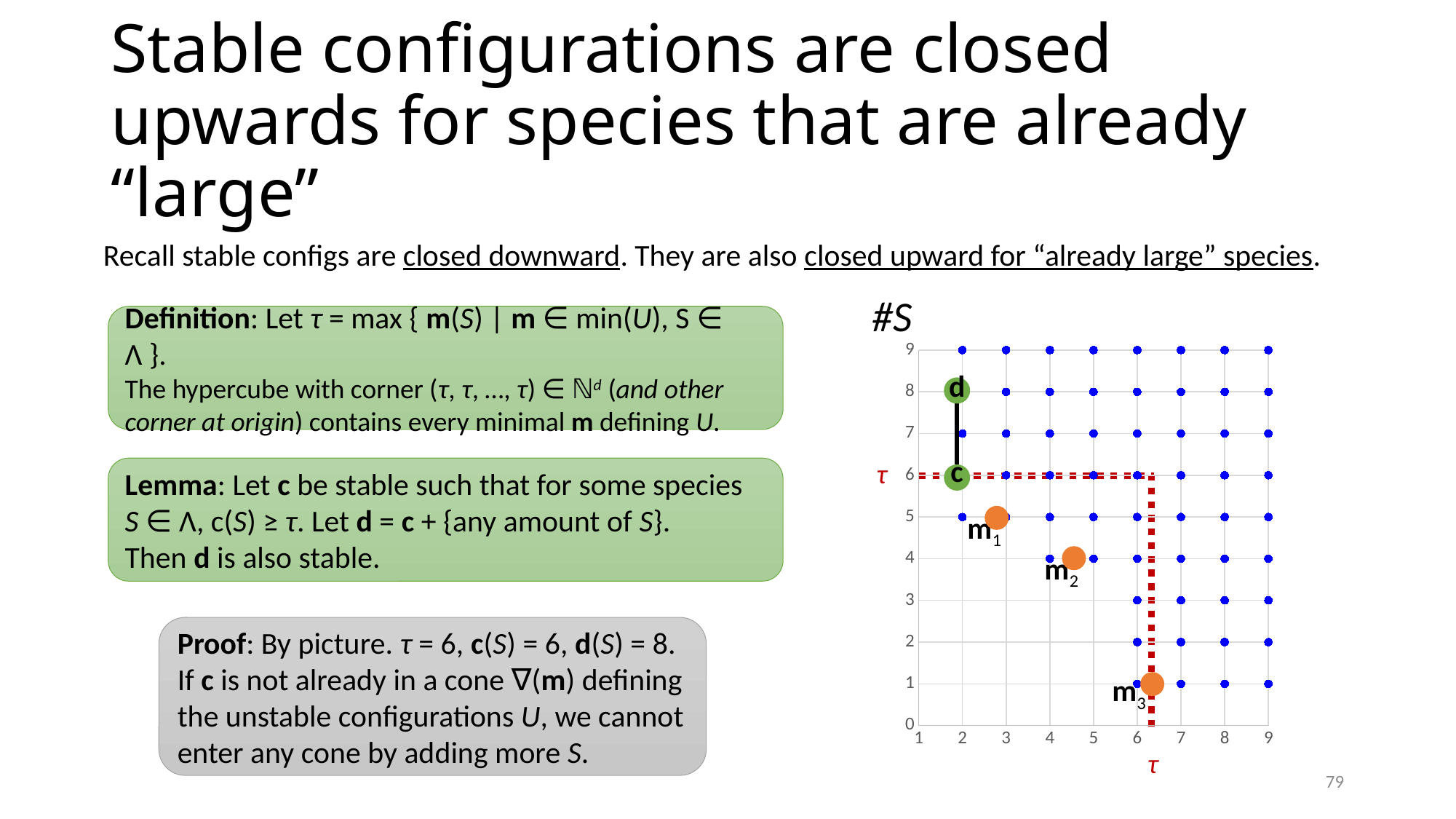
What kind of chart is shown on the right of the slide? scatter chart What is the #S value of the point labelled m1? 5 What is the #S value of the point labelled m3? 1 How many orange points labelled m are plotted on the chart? 3 Which has the larger #S value, m1 or m2? m1 Is the horizontal-axis value of the point m3 greater or less than 5? greater What is the #S value of the point labelled d? 8 What is the label of the vertical axis of the chart? #S Which of the orange points m1, m2, m3 has the lowest #S value? m3 What is the #S value of the point labelled c? 6 What is the difference in #S between the points d and c? 2 Which of the orange points m1, m2, m3 has the highest #S value? m1